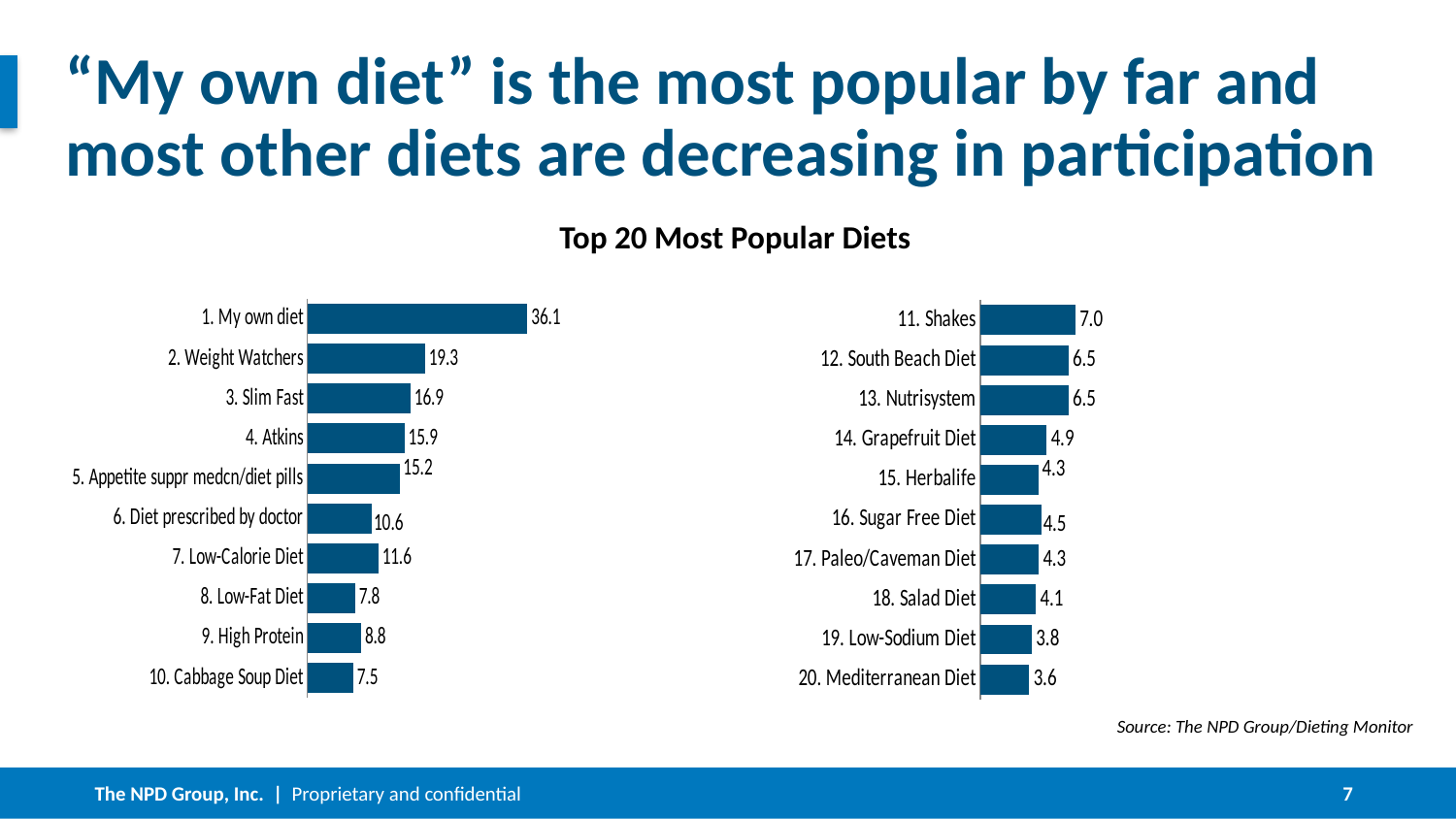
In the right chart, what is the difference between the values for 11. Shakes and 20. Mediterranean Diet? 3.4 In the right chart, what is the value for 14. Grapefruit Diet? 4.9 In the left chart, what is the value for 1. My own diet? 36.1 In the left chart, what is the value for 9. High Protein? 8.8 How many bars are shown in the left chart? 10 In the left chart, which has the larger value: 6. Diet prescribed by doctor or 7. Low-Calorie Diet? 7. Low-Calorie Diet In the left chart, which diet has the highest value? 1. My own diet In the right chart, which diet has the lowest value? 20. Mediterranean Diet What type of chart is the right chart? Bar chart In the left chart, what is the difference between the values for 1. My own diet and 2. Weight Watchers? 16.8 In the left chart, which diet has the lowest value? 10. Cabbage Soup Diet What is the title shown above the two charts? Top 20 Most Popular Diets